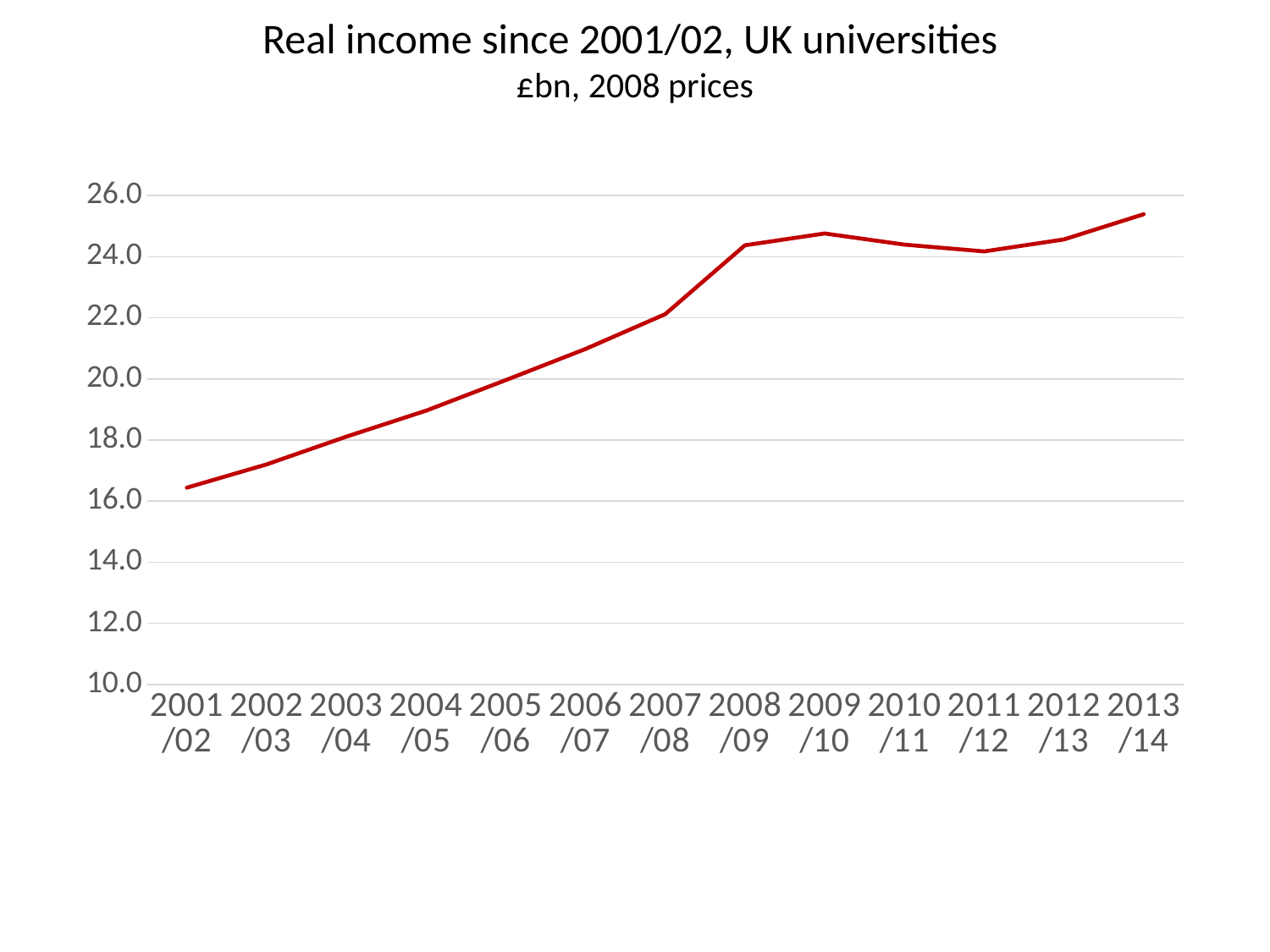
How many academic years are plotted on the x axis? 13 Does real income rise or fall between 2001/02 and 2008/09? Rise Is the value for 2011/12 greater or less than 22.0? greater Is the value for 2008/09 greater or less than 24.0? greater Which year has the higher real income, 2009/10 or 2013/14? 2013/14 Is the value for 2004/05 greater or less than 20.0? less What unit and price basis does the chart subtitle give for the values? £bn, 2008 prices What kind of chart is shown on the slide? Line chart Which year has the lowest real income? 2001/02 Which year has the highest real income? 2013/14 What is the title of the chart? Real income since 2001/02, UK universities